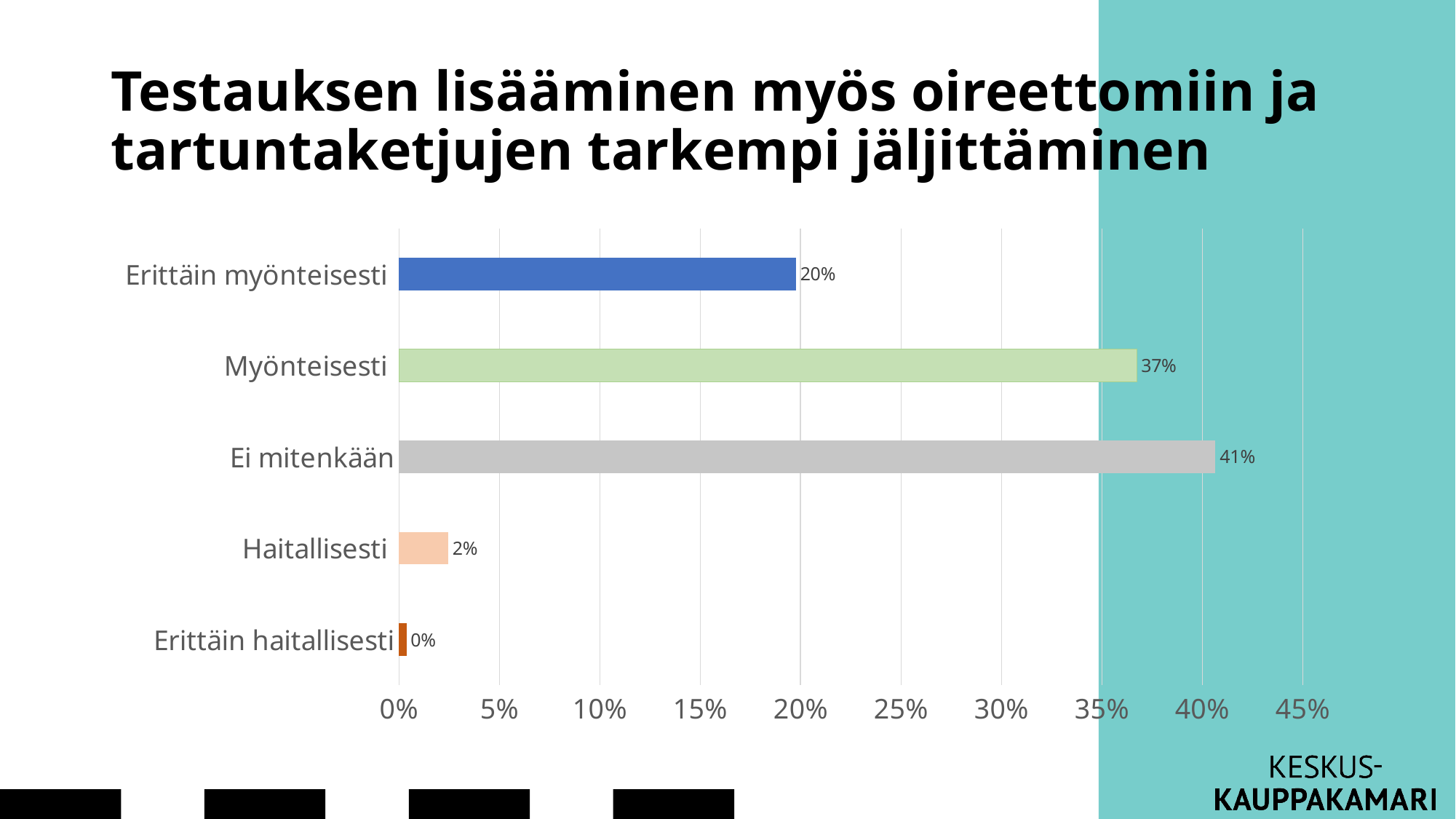
What is the value for Erittäin haitallisesti? 0% Which category has the highest value? Ei mitenkään Is the value for Ei mitenkään greater or less than 35%? greater How many categories are shown in the chart? 5 Which category has the lowest value? Erittäin haitallisesti What kind of chart is shown on the slide? Bar chart What is the difference between the values for Erittäin myönteisesti and Haitallisesti? 18% Which is larger, the value for Erittäin myönteisesti or the value for Myönteisesti? Myönteisesti What is the difference between the values for Ei mitenkään and Myönteisesti? 4% What is the value for Myönteisesti? 37% What is the value for Erittäin myönteisesti? 20% What is the value for Haitallisesti? 2%